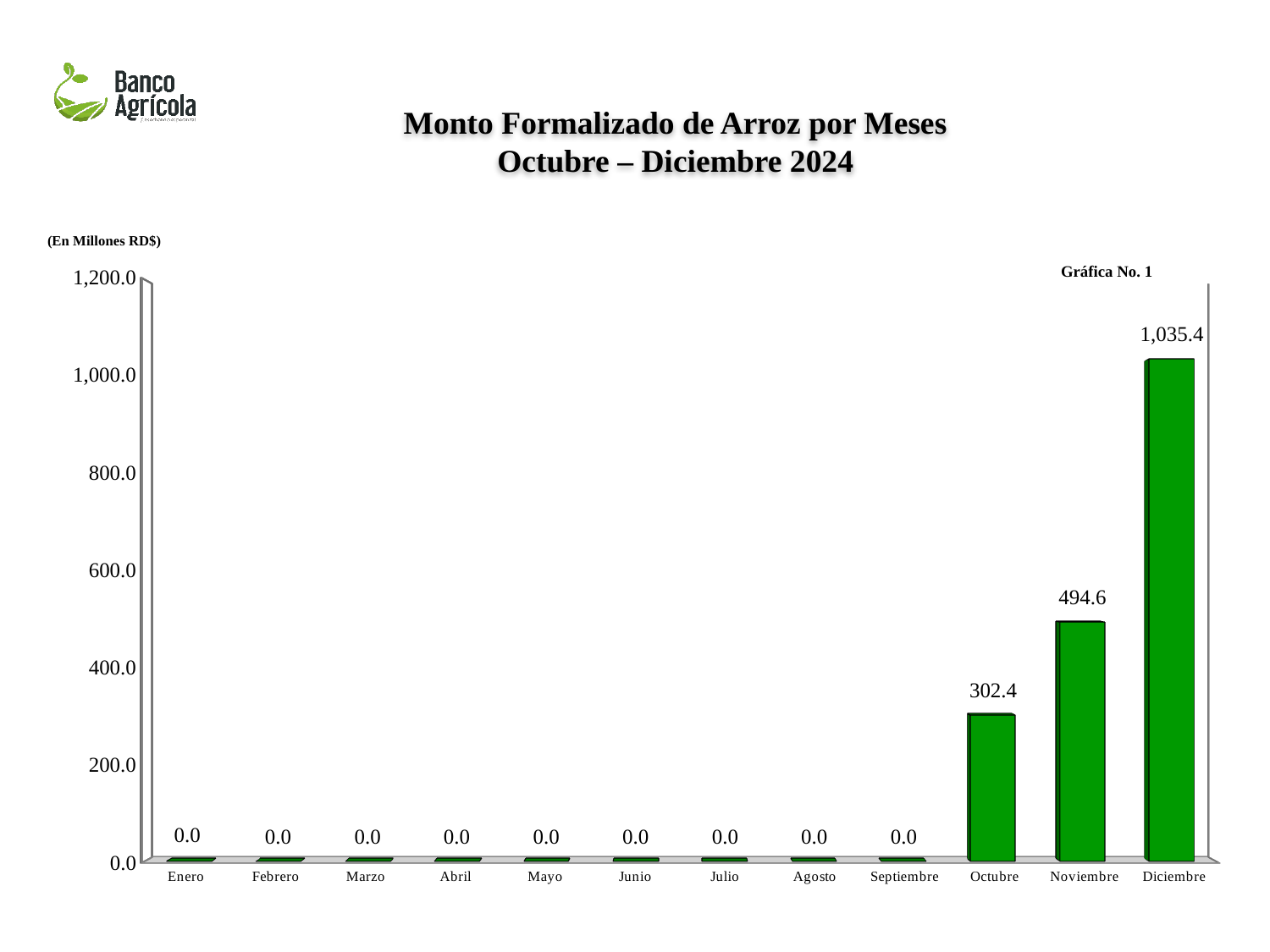
Is the value for Diciembre greater or less than 1,000.0? greater Which is larger, the value for Octubre or the value for Noviembre? Noviembre What is the value for Octubre? 302.4 What is the difference between the values for Noviembre and Octubre? 192.2 How many months are shown on the x axis? 12 What unit is stated for the values in the chart? En Millones RD$ What is the difference between the values for Diciembre and Noviembre? 540.8 What kind of chart is shown on the slide? bar chart What is the value for Septiembre? 0.0 What is the value for Diciembre? 1,035.4 What is the value for Noviembre? 494.6 Which month has the highest value? Diciembre